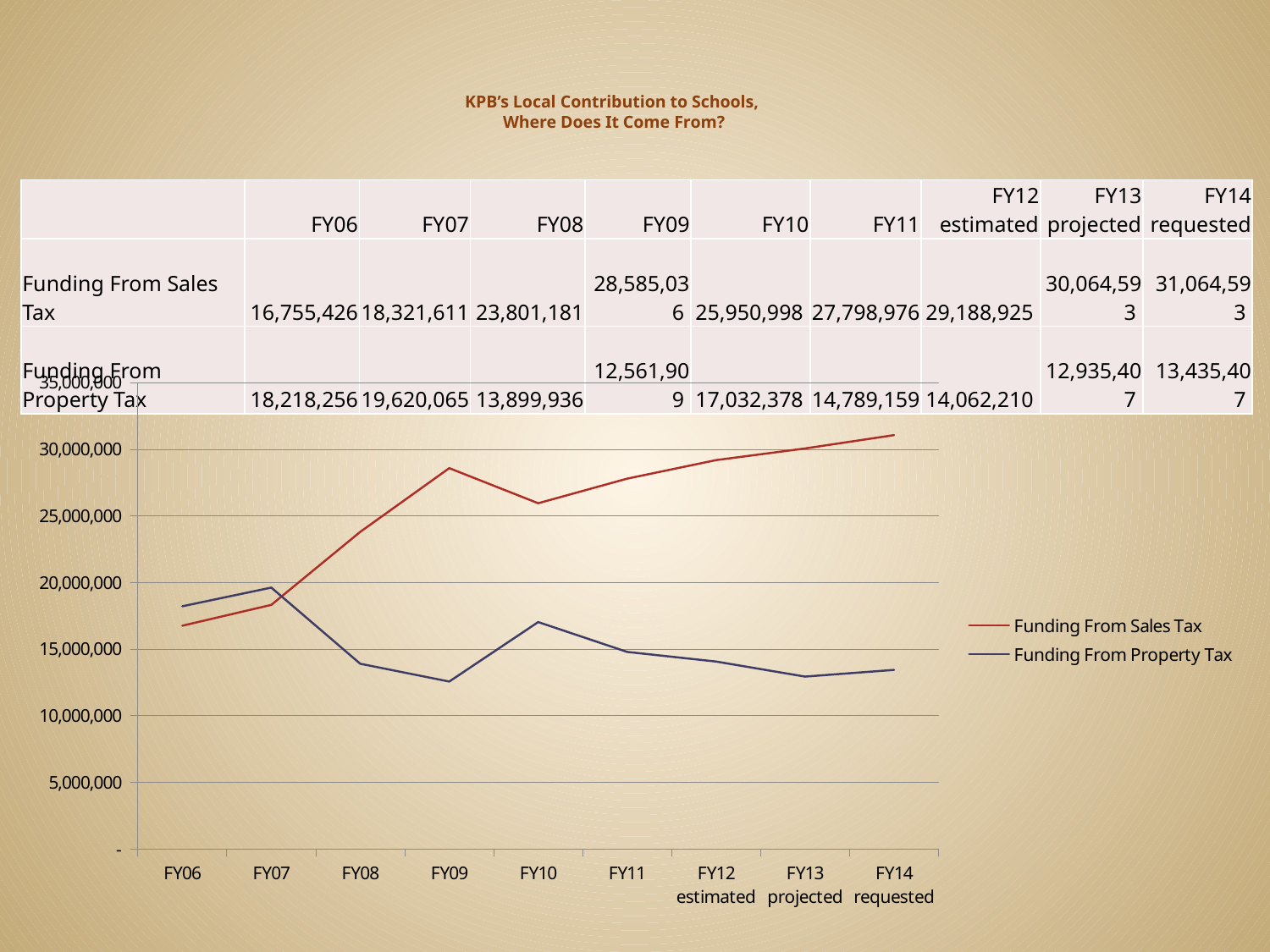
Is the value for Funding From Property Tax in FY08 greater or less than 15,000,000? less How many fiscal-year categories are plotted along the x axis? 9 What is the difference between Funding From Sales Tax and Funding From Property Tax in FY14 requested? 17,629,186 Which is larger in FY06, Funding From Sales Tax or Funding From Property Tax? Funding From Property Tax What is the FY14 requested value for Funding From Sales Tax? 31,064,593 How many series does the chart legend list? 2 What is the value of Funding From Sales Tax for FY09? 28,585,036 In which fiscal year is Funding From Sales Tax highest? FY14 requested What kind of chart is shown on the slide? line chart What is the value of Funding From Property Tax for FY10? 17,032,378 What colour is the Funding From Sales Tax line? red In which fiscal year is Funding From Property Tax lowest? FY09